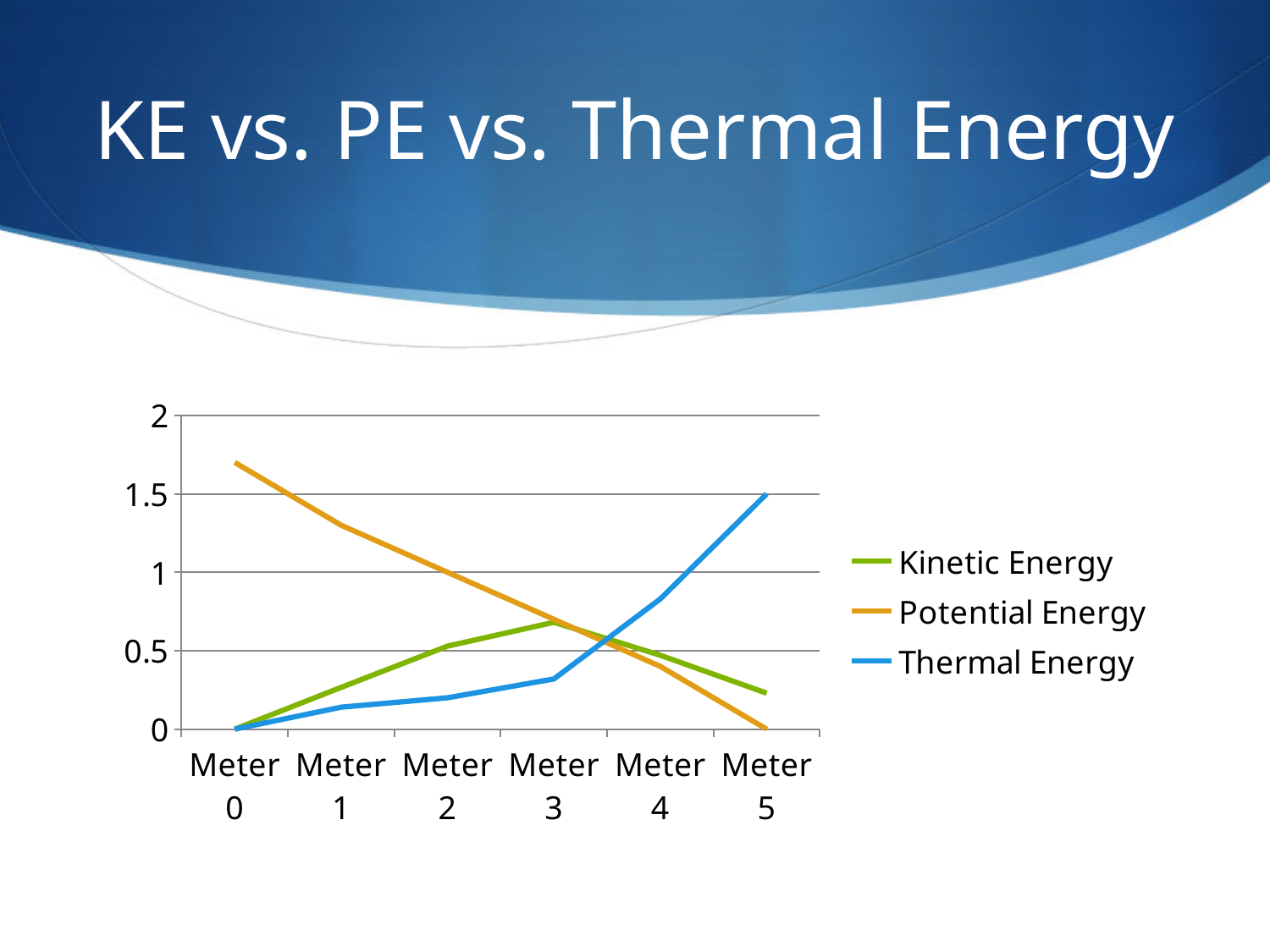
Does the Thermal Energy line rise or fall from Meter 0 to Meter 5? rise Does the Potential Energy line rise or fall from Meter 0 to Meter 5? fall What is the value of Potential Energy at Meter 5? 0 Which series has the highest value at Meter 0? Potential Energy At Meter 5, which is larger: Thermal Energy or Kinetic Energy? Thermal Energy What is the value of Thermal Energy at Meter 5? 1.5 What kind of chart is shown on the slide? line chart How many series does the legend list? 3 Is the value for Potential Energy at Meter 0 greater or less than 1.5? greater Is the value for Kinetic Energy at Meter 5 greater or less than 0.5? less How many points are plotted along the x axis for each series? 6 Is the value for Kinetic Energy at Meter 3 greater or less than 0.5? greater